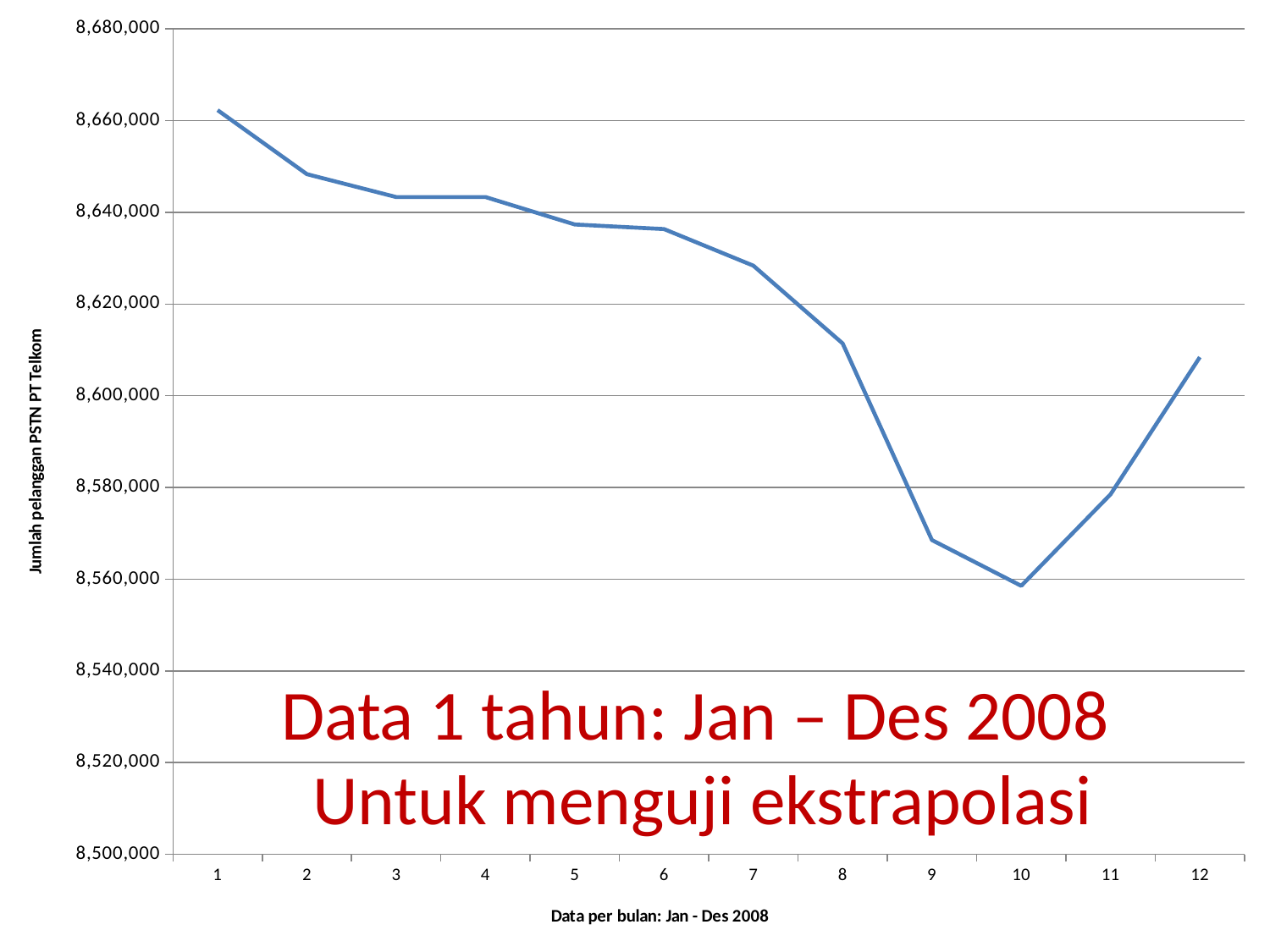
Is the value for month 9 greater or less than 8,580,000? less Is the value for month 7 greater or less than 8,620,000? greater What is the title of the vertical axis? Jumlah pelanggan PSTN PT Telkom Is the value for month 10 greater or less than 8,580,000? less Which month has the highest number of PSTN subscribers? 1 How many data points (months) are plotted on the x axis? 12 Does the line generally rise or fall from month 1 to month 10? fall Which month has the lowest number of PSTN subscribers? 10 Which is larger, the value for month 1 or the value for month 12? month 1 What kind of chart is shown on the slide? line chart